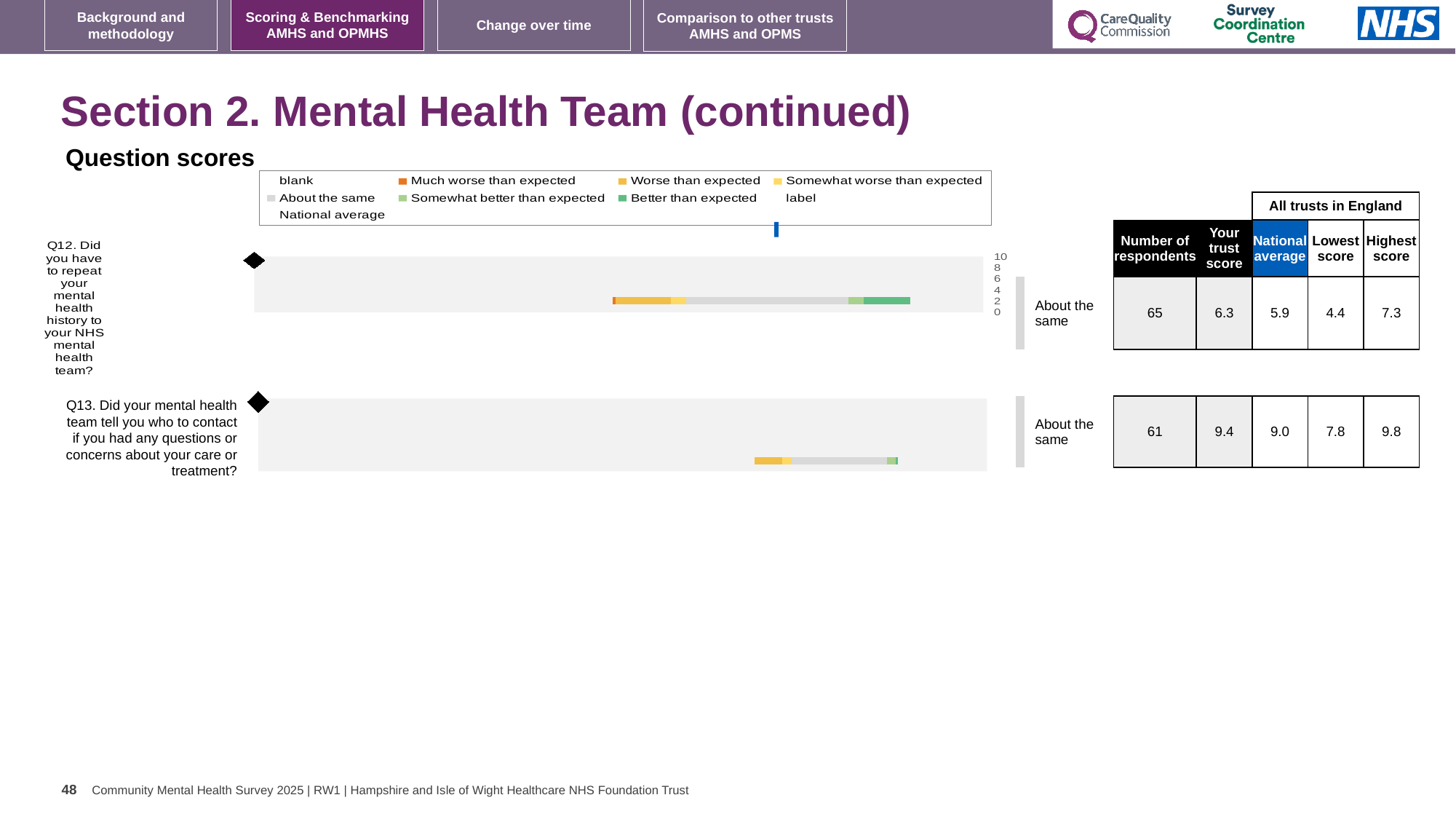
How many questions (bars) are plotted in the question scores charts on this slide? 2 For the Q13 chart, how much higher is the trust's score (9.4) than the national average (9.0)? 0.4 For the Q12 chart, what is the national average score? 5.9 For the Q13 chart, what is the highest score among all trusts in England? 9.8 For the Q13 chart, which is larger: the trust's score or the national average? the trust's score (9.4) What benchmark category label is shown next to the Q12 chart? About the same How many respondents are recorded for the Q13 chart? 61 What kind of chart is used to show the question scores on this slide? bar chart For the Q13 chart (who to contact with questions or concerns), what is the trust's score shown in the table? 9.4 For the Q12 chart, what is the difference between the highest score (7.3) and the lowest score (4.4) across all trusts? 2.9 How many entries does the legend above the question score charts list? 9 For the Q12 chart (repeating mental health history), what is the trust's score shown in the table? 6.3